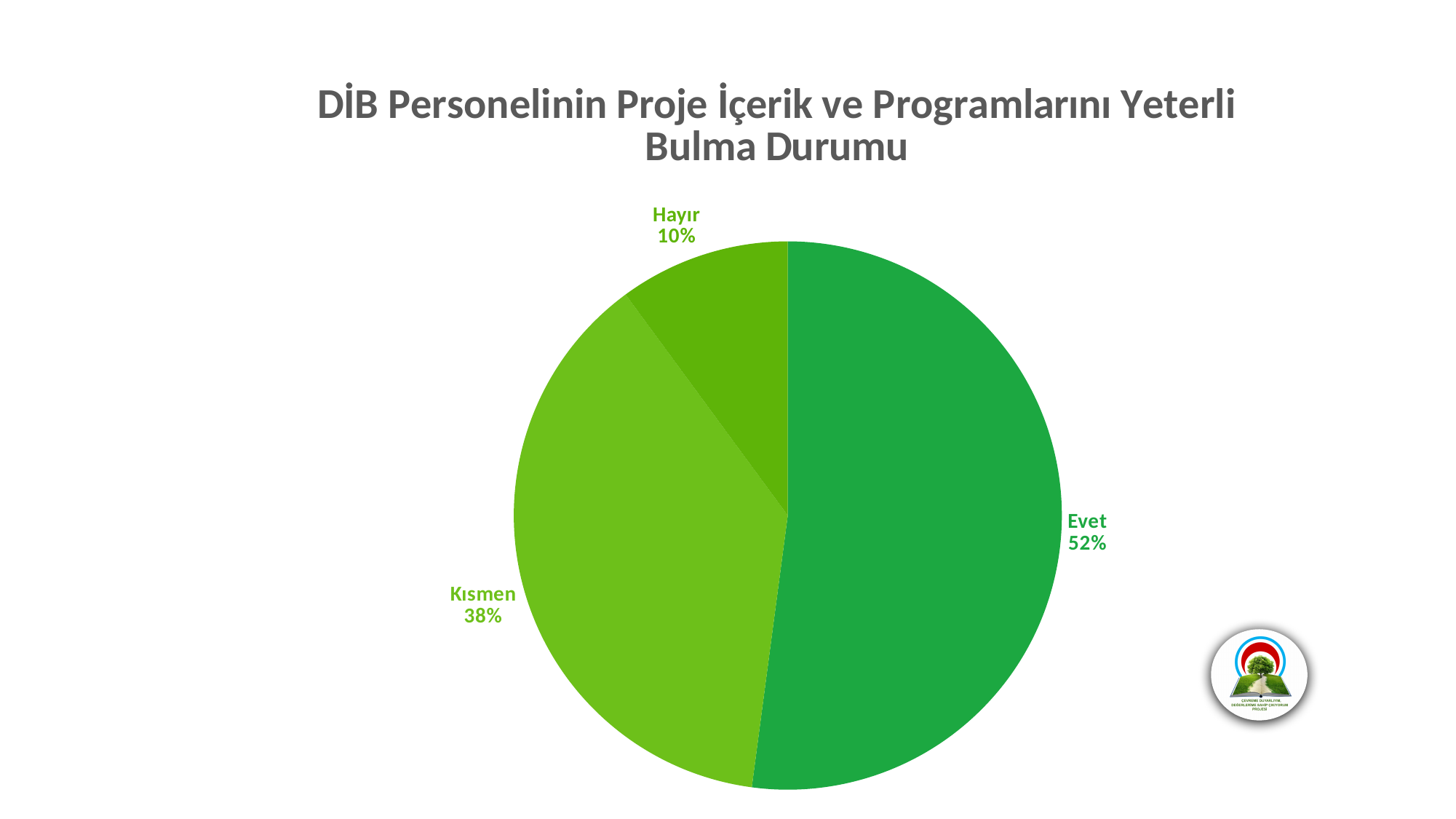
What share of the pie does Kısmen represent? 38% Which is larger, the share for Kısmen or the share for Hayır? Kısmen Is the share for Evet greater or less than 50%? greater What is the difference in percentage points between Evet and Kısmen? 14 What share of the pie does Evet represent? 52% What share of the pie does Hayır represent? 10% What is the difference in percentage points between Kısmen and Hayır? 28 What kind of chart is shown on the slide? Pie chart Which category has the smallest slice of the pie? Hayır Which category has the largest slice of the pie? Evet What is the title of the chart? DİB Personelinin Proje İçerik ve Programlarını Yeterli Bulma Durumu How many categories are shown in the pie chart? 3